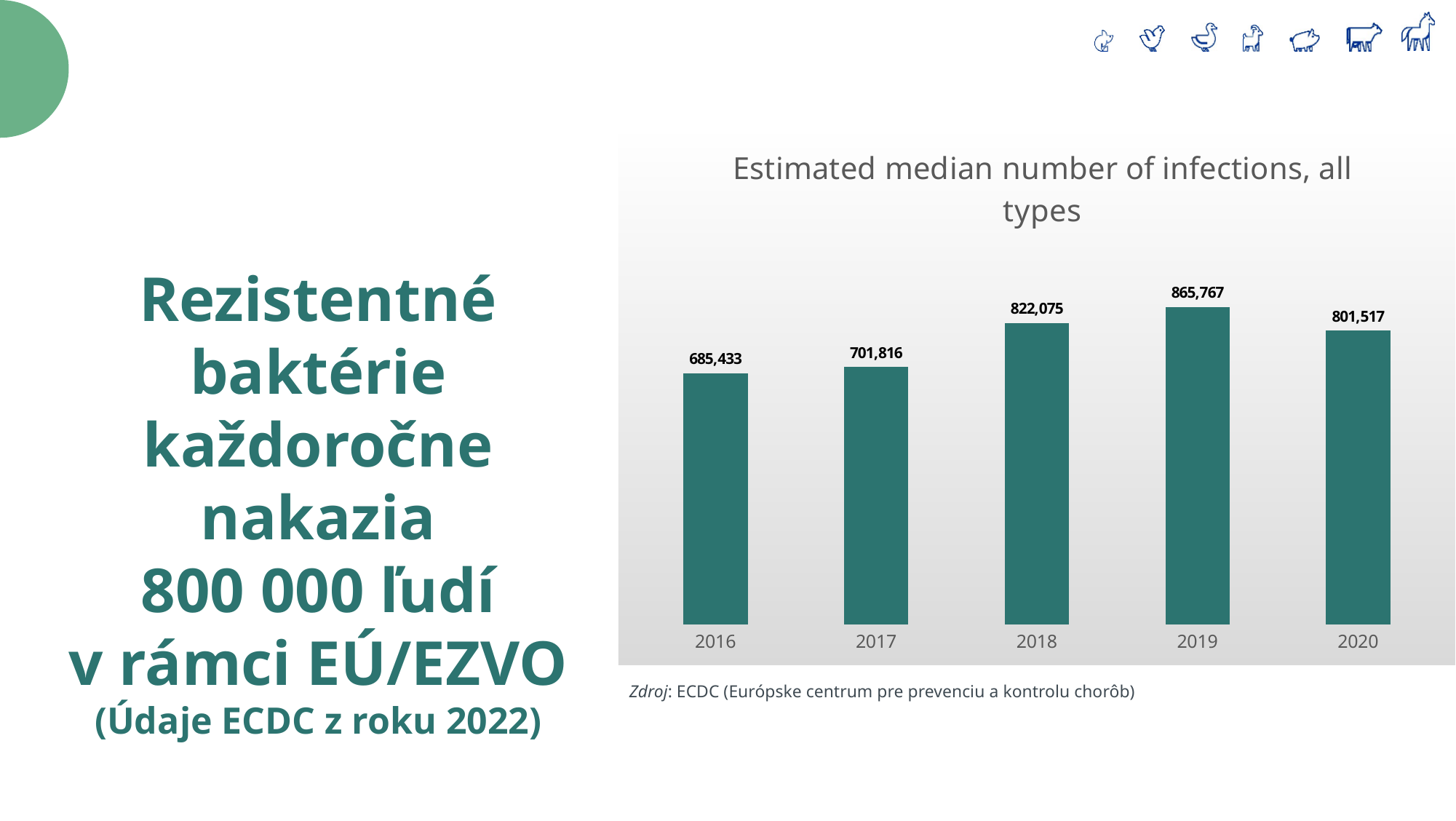
Which year has the lowest estimated median number of infections? 2016 What is the difference between the 2017 and 2016 values? 16,383 What is the estimated median number of infections in 2019? 865,767 What is the estimated median number of infections in 2020? 801,517 Which year has a higher value, 2018 or 2020? 2018 What is the difference between the 2019 and 2020 values? 64,250 What type of chart is shown on the slide? bar chart What is the title of the chart? Estimated median number of infections, all types How many years are shown on the x axis of the chart? 5 Which year has the highest estimated median number of infections? 2019 Does the estimated median number of infections rise or fall from 2016 to 2019? rise What is the estimated median number of infections in 2016? 685,433